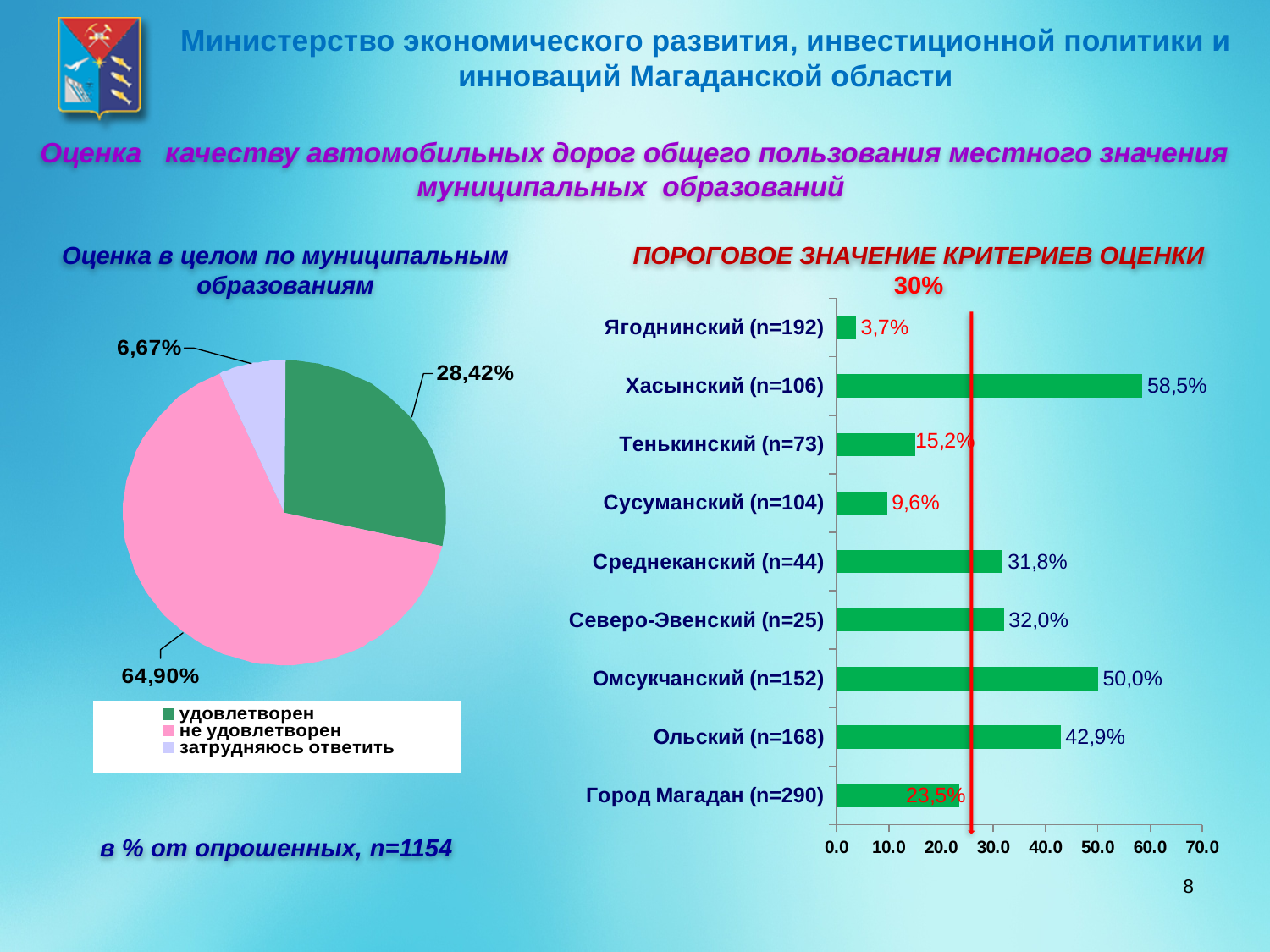
In the bar chart on the right, which municipality has the highest value? Хасынский (n=106) In the pie chart on the left, what share of respondents answered "не удовлетворен"? 64,90% What type of chart is shown on the right side of the slide? bar chart In the bar chart on the right, how many municipalities are plotted? 9 In the pie chart on the left, how many categories does the legend list? 3 In the bar chart on the right, what is the value for Хасынский (n=106)? 58,5% In the bar chart on the right, which municipality has the lowest value? Ягоднинский (n=192) In the bar chart on the right, what is the value for Город Магадан (n=290)? 23,5% In the bar chart on the right, what is the difference between the values for Омсукчанский (n=152) and Ольский (n=168)? 7,1% In the pie chart on the left, what share of respondents answered "удовлетворен"? 28,42% In the pie chart on the left, which category has the smallest slice? затрудняюсь ответить In the bar chart on the right, which is larger: the value for Тенькинский (n=73) or Сусуманский (n=104)? Тенькинский (n=73)